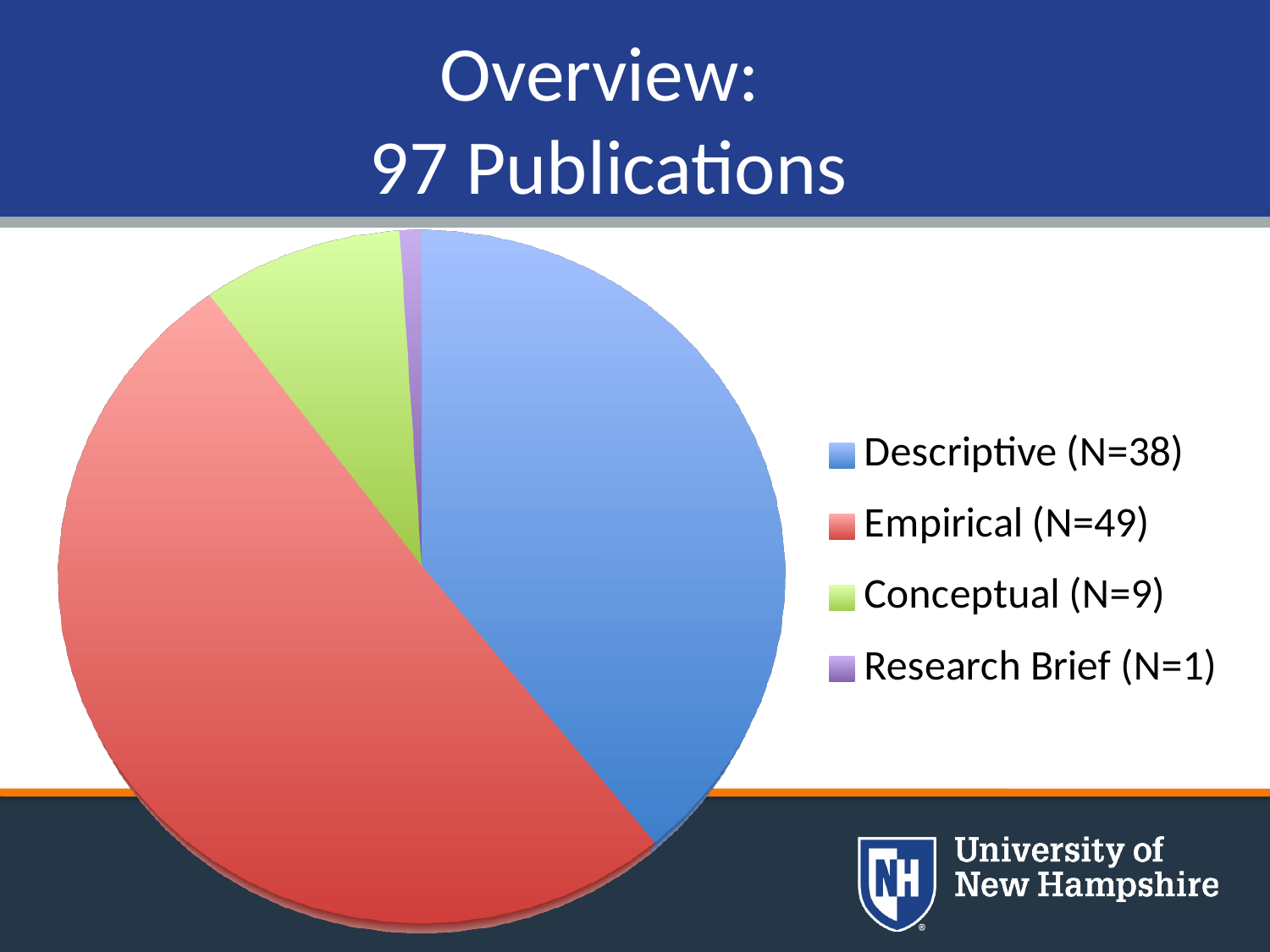
What is the N value for Empirical in the pie chart? 49 Which has a larger N value, Descriptive or Conceptual? Descriptive Which category has the largest slice of the pie chart? Empirical How many categories does the pie chart show? 4 What is the total number of publications shown in the chart, according to the slide title? 97 What is the N value for Conceptual in the pie chart? 9 What is the N value for Research Brief in the pie chart? 1 Which category has the smallest slice of the pie chart? Research Brief What colour is the Empirical slice in the pie chart? Red What is the N value for Descriptive in the pie chart? 38 What is the difference between the N values for Empirical and Descriptive? 11 What kind of chart is shown on the slide? Pie chart